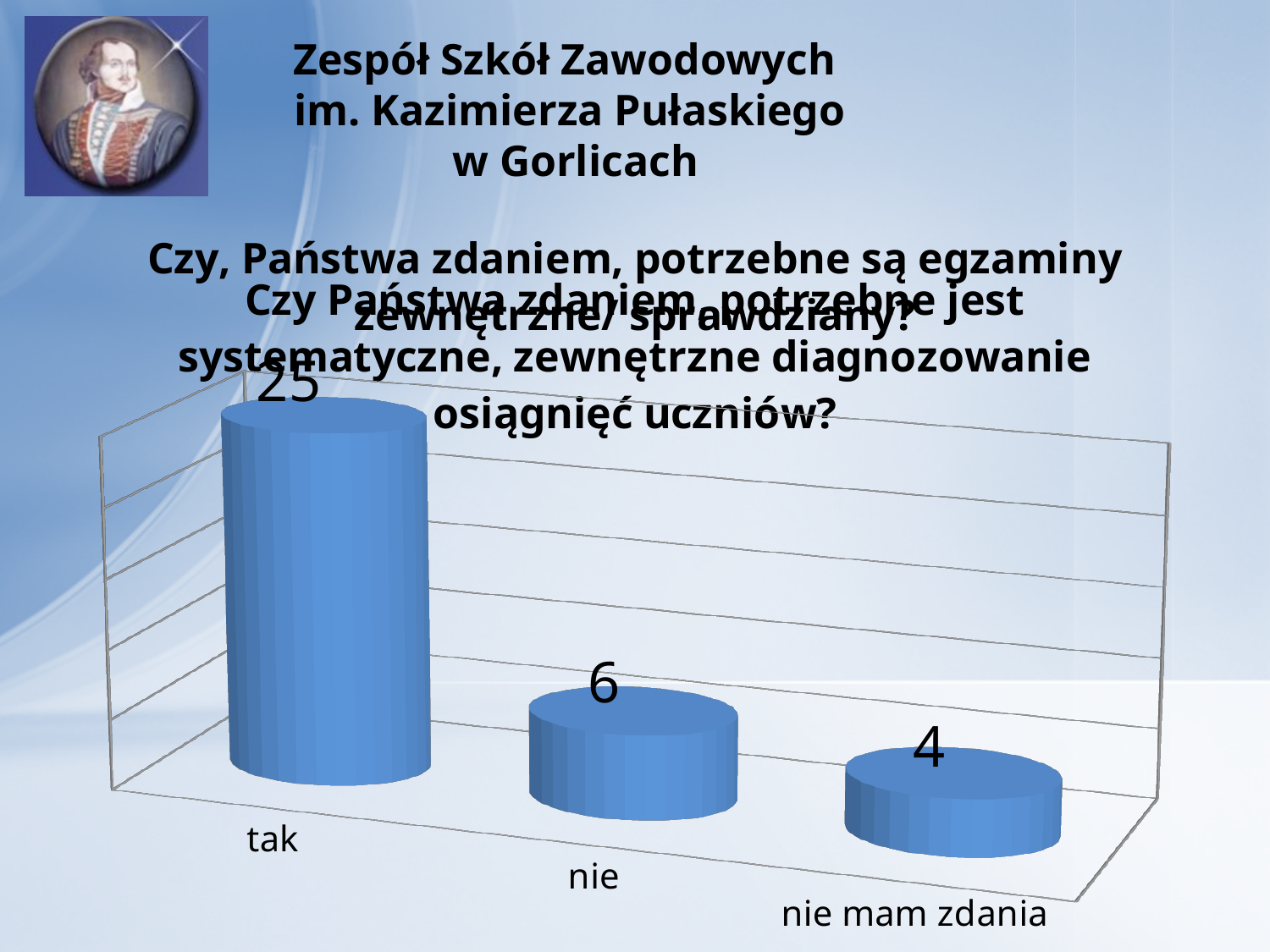
Which is larger, the value for "nie" or the value for "nie mam zdania"? nie Which category has the lowest value? nie mam zdania What is the difference between the values for "nie" and "nie mam zdania"? 2 What is the value for "nie"? 6 What kind of chart is shown on the slide? bar chart What is the value for "tak"? 25 What is the difference between the values for "tak" and "nie"? 19 What is the value for "nie mam zdania"? 4 What is the total of the three values shown in the chart? 35 How many categories are shown in the chart? 3 Which category has the highest value? tak Do the values rise or fall from left to right across the categories? fall